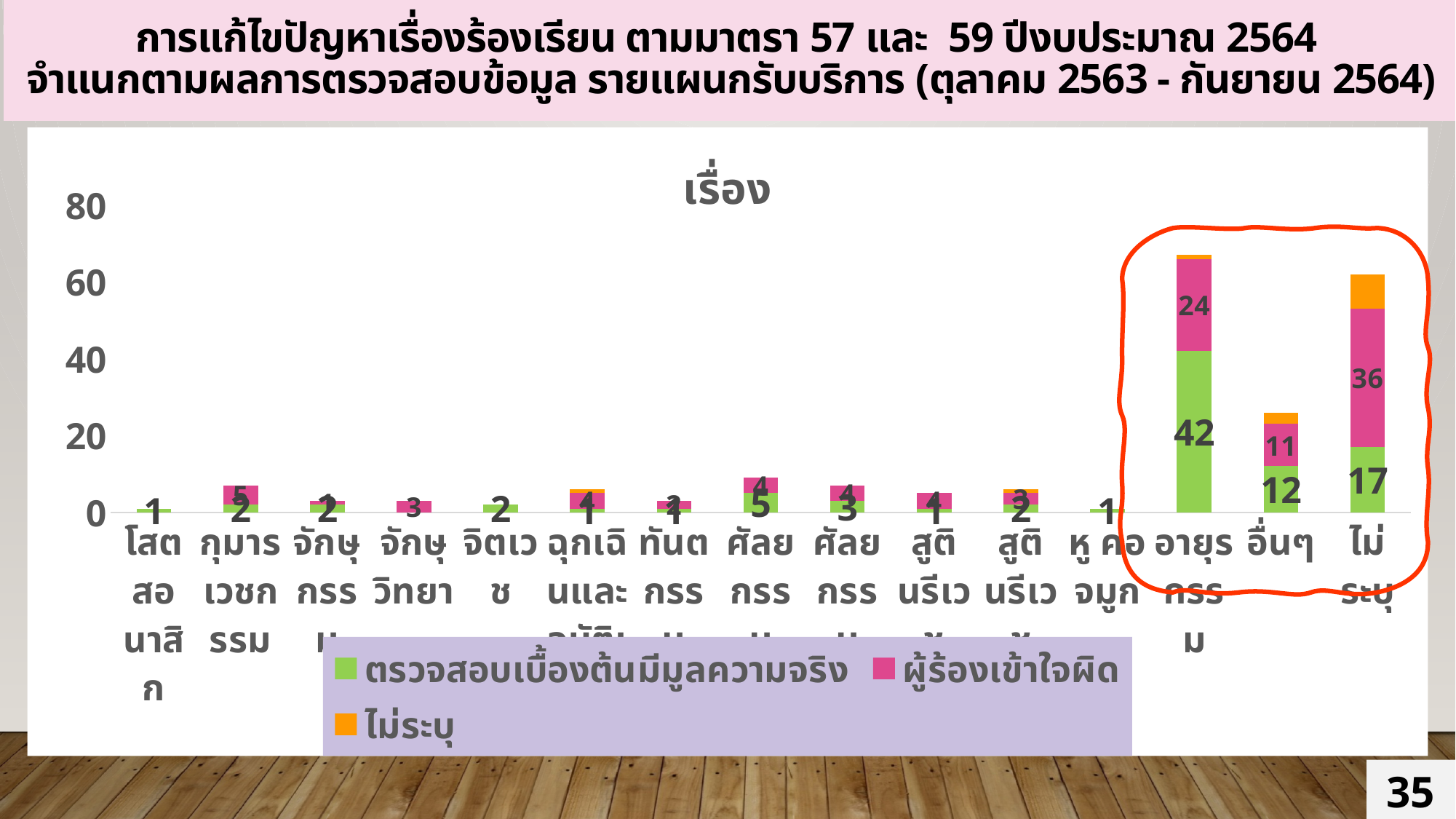
What is the value of ผู้ร้องเข้าใจผิด for อื่นๆ? 11 Which has the larger ผู้ร้องเข้าใจผิด value, อายุรกรรม or ไม่ระบุ? ไม่ระบุ What is the value of ตรวจสอบเบื้องต้นมีมูลความจริง for อื่นๆ? 12 Which category has the tallest stacked bar? อายุรกรรม How many series does the legend list? 3 What is the value of ผู้ร้องเข้าใจผิด for ไม่ระบุ? 36 What is the value of ตรวจสอบเบื้องต้นมีมูลความจริง for ไม่ระบุ? 17 Is the total stacked value for ไม่ระบุ greater or less than 40? greater What is the value of ตรวจสอบเบื้องต้นมีมูลความจริง for อายุรกรรม? 42 What is the difference between the ตรวจสอบเบื้องต้นมีมูลความจริง values for อายุรกรรม and ไม่ระบุ? 25 What is the value of ผู้ร้องเข้าใจผิด for อายุรกรรม? 24 What kind of chart is shown on the slide? stacked bar chart